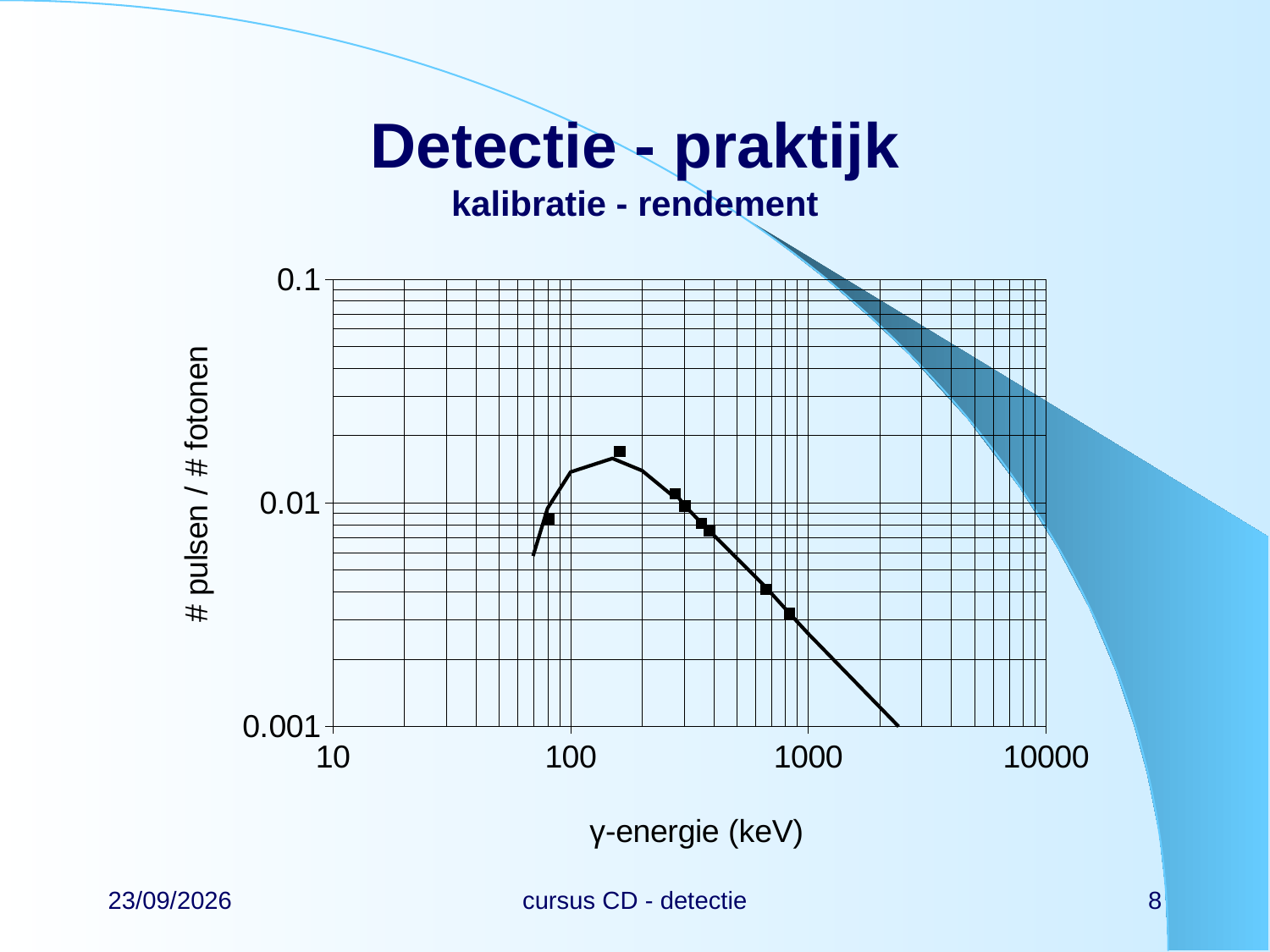
Is the value of the curve at 100 keV greater or less than 0.01? greater Does the curve rise or fall between about 70 keV and 150 keV? It rises How does the curve behave as the γ-energy increases from 100 keV to 1000 keV? It rises slightly to a peak near 150 keV, then falls steadily What kind of chart is shown on the slide? Line chart with data point markers (log-log scatter plot) Is the peak value of the curve greater or less than 0.01? greater Is the value of the curve at 1000 keV greater or less than 0.001? greater What is the title of the y axis of the chart? # pulsen / # fotonen Which is larger: the value of the curve at 100 keV or at 1000 keV? 100 keV What is the title of the x axis of the chart? γ-energie (keV) What are the lowest and highest tick values shown on the x axis? 10 and 10000